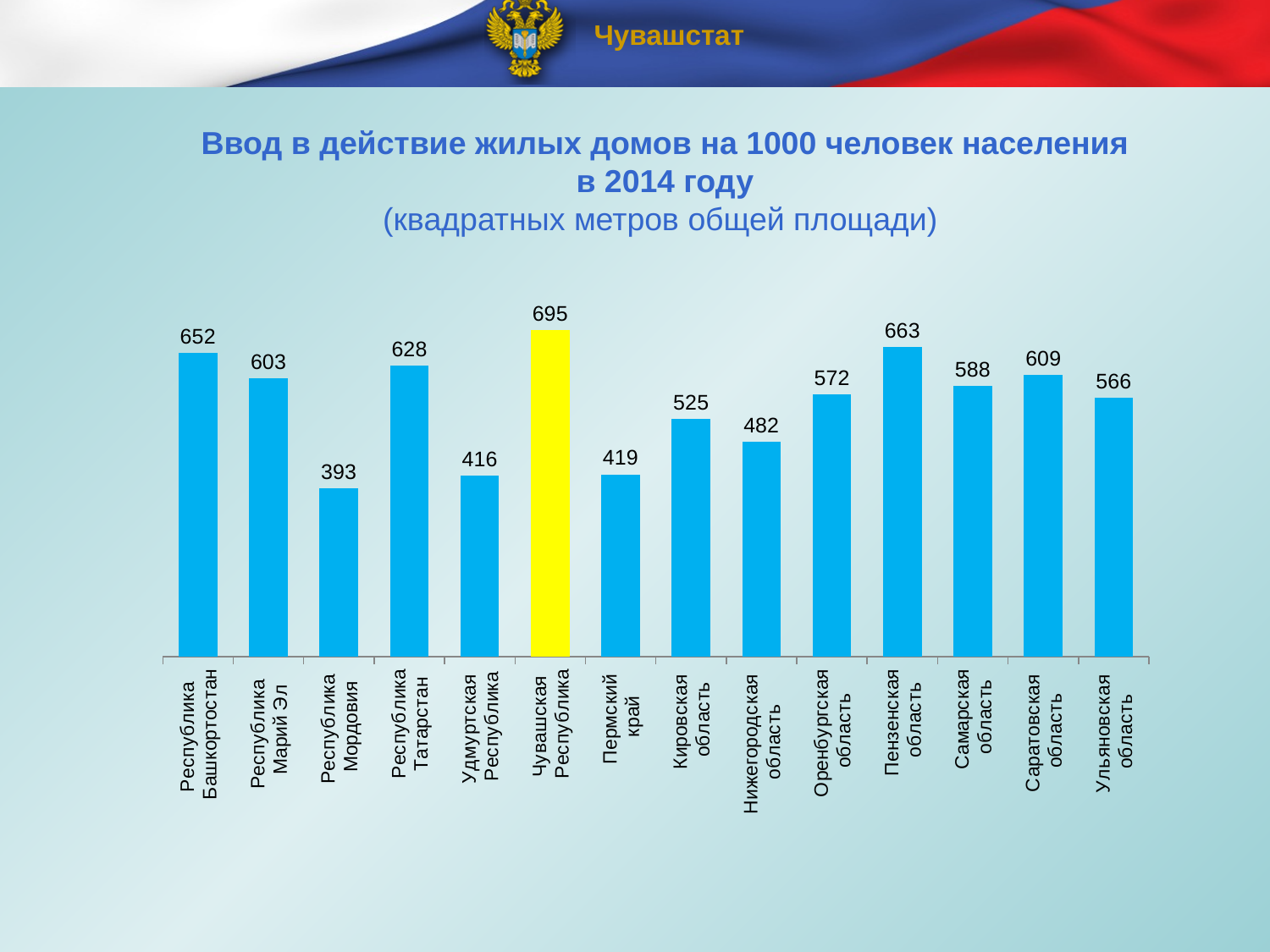
Which is larger, the value for Удмуртская Республика or the value for Пермский край? Пермский край What is the value for Чувашская Республика? 695 Which is larger, the value for Самарская область or the value for Саратовская область? Саратовская область Which region has the highest value? Чувашская Республика Which region has the lowest value? Республика Мордовия What kind of chart is shown on the slide? Bar chart What is the value for Республика Мордовия? 393 What is the difference between the values for Республика Башкортостан and Республика Татарстан? 24 What is the difference between the values for Чувашская Республика and Пензенская область? 32 Which bar is highlighted in yellow? Чувашская Республика What is the value for Нижегородская область? 482 How many regions are shown in the chart? 14